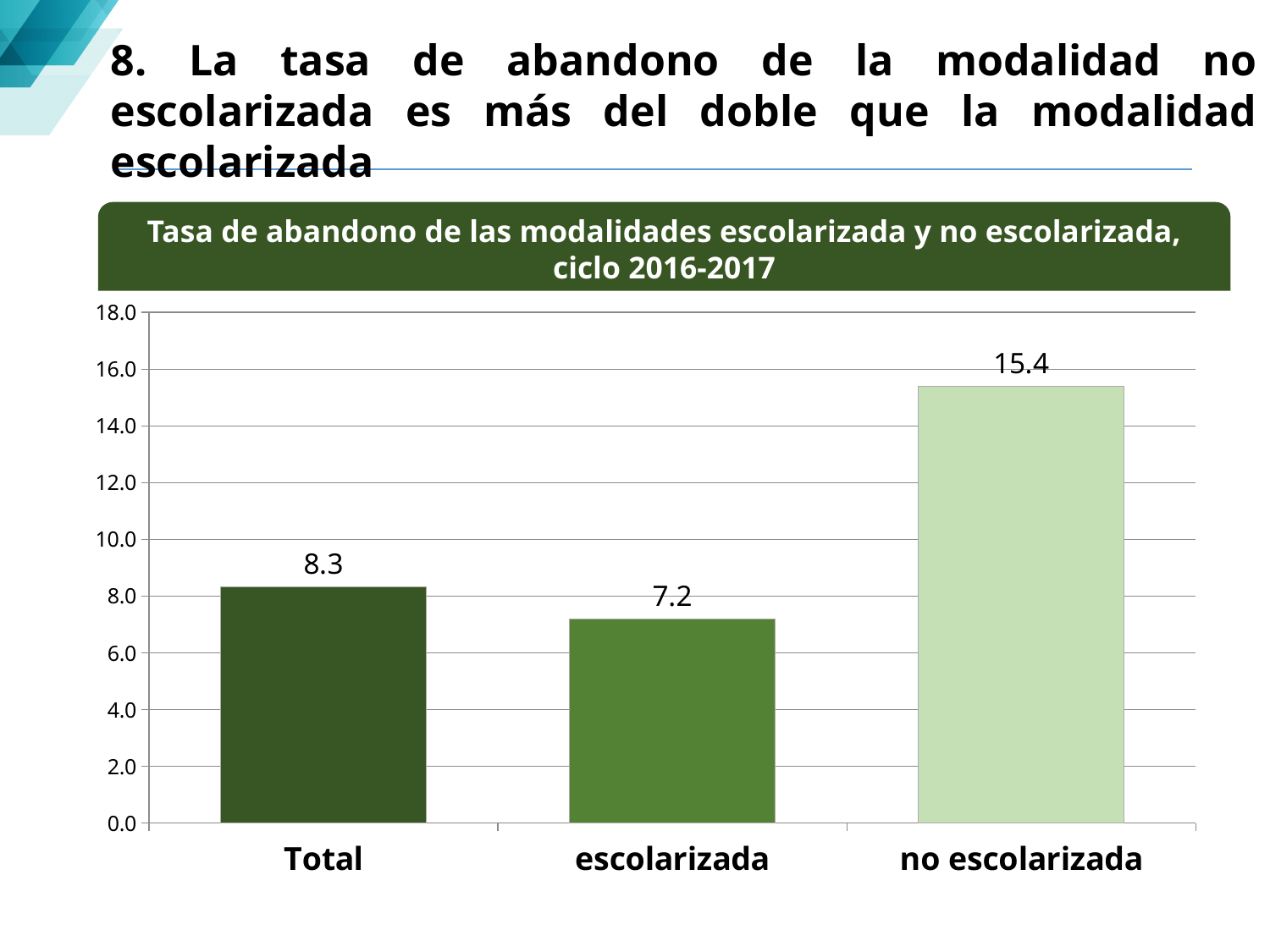
What is the value for 'no escolarizada'? 15.4 What kind of chart is shown on the slide? bar chart Which category has the lowest value? escolarizada Which category has the highest value? no escolarizada What is the value for 'escolarizada'? 7.2 Which is larger, the value for 'Total' or the value for 'escolarizada'? Total How many categories are shown on the x axis? 3 What is the difference between the values for 'Total' and 'escolarizada'? 1.1 What is the title of the chart? Tasa de abandono de las modalidades escolarizada y no escolarizada, ciclo 2016-2017 Is the value for 'no escolarizada' greater or less than 14.0? greater What is the difference between the values for 'no escolarizada' and 'escolarizada'? 8.2 What is the value for 'Total'? 8.3